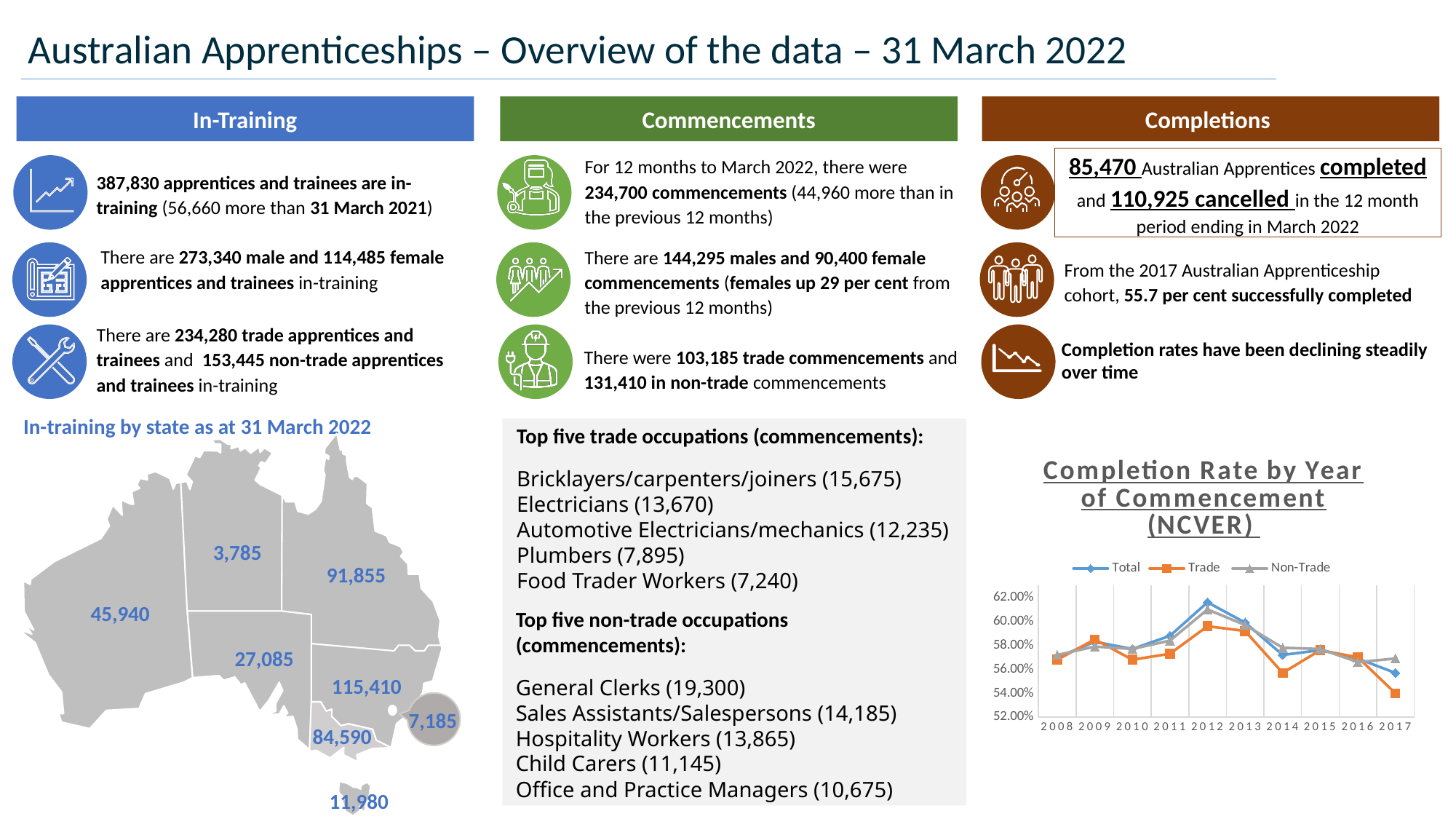
In the 'Completion Rate by Year of Commencement' chart, which series is higher in 2012, Total or Trade? Total In the 'Completion Rate by Year of Commencement' chart, does the Total series rise or fall from 2012 to 2017? fall In the 'Completion Rate by Year of Commencement' chart, which series is higher in 2017, Non-Trade or Trade? Non-Trade In the 'Completion Rate by Year of Commencement' chart, which year has the highest Total completion rate? 2012 What are the series names in the legend of the 'Completion Rate by Year of Commencement' chart? Total, Trade, Non-Trade In the 'Completion Rate by Year of Commencement' chart, is the Trade value for 2017 greater or less than 56.00%? less How many years are shown on the x axis of the 'Completion Rate by Year of Commencement' chart? 10 In the 'Completion Rate by Year of Commencement' chart, is the Total value for 2012 greater or less than 60.00%? greater In the 'Completion Rate by Year of Commencement' chart, is the Non-Trade value for 2012 greater or less than 60.00%? greater In the 'Completion Rate by Year of Commencement' chart, which year has the lowest Trade completion rate? 2017 What kind of chart is the 'Completion Rate by Year of Commencement (NCVER)' chart? line chart How many series does the legend of the 'Completion Rate by Year of Commencement' chart list? 3